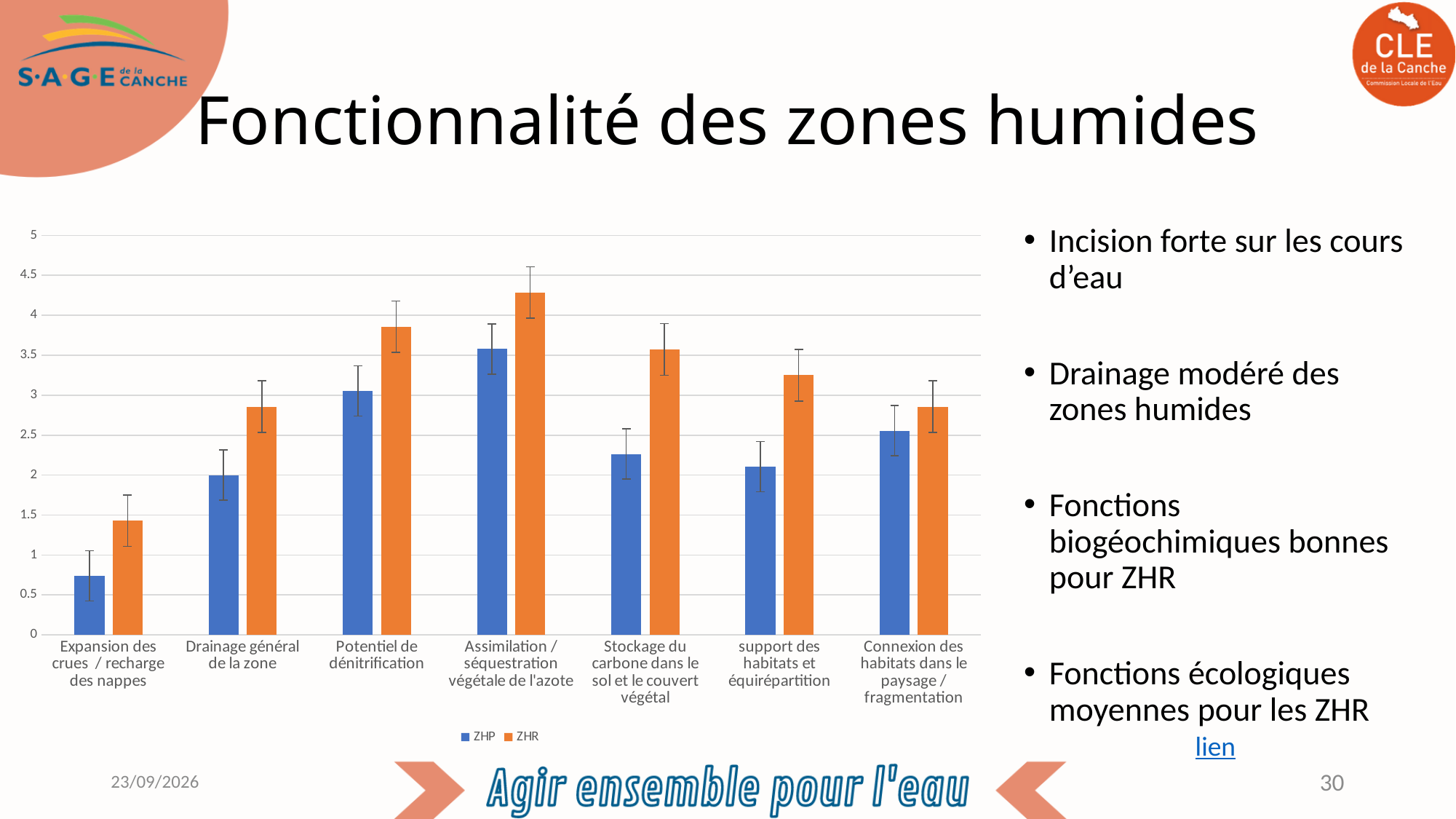
Is the ZHP value for support des habitats et équirépartition greater or less than 2.5? less Which category has the lowest ZHR bar? Expansion des crues / recharge des nappes What kind of chart is shown on the slide? bar chart How many categories are shown on the x axis of the chart? 7 For Potentiel de dénitrification, which series has the larger value, ZHP or ZHR? ZHR How many series does the chart legend list? 2 Is the ZHR value for Stockage du carbone dans le sol et le couvert végétal greater or less than 3? greater Is the ZHP value for Expansion des crues / recharge des nappes greater or less than 1? less Which category has the lowest ZHP bar? Expansion des crues / recharge des nappes What colour are the ZHR bars in the chart? orange Which category has the highest ZHR bar? Assimilation / séquestration végétale de l'azote